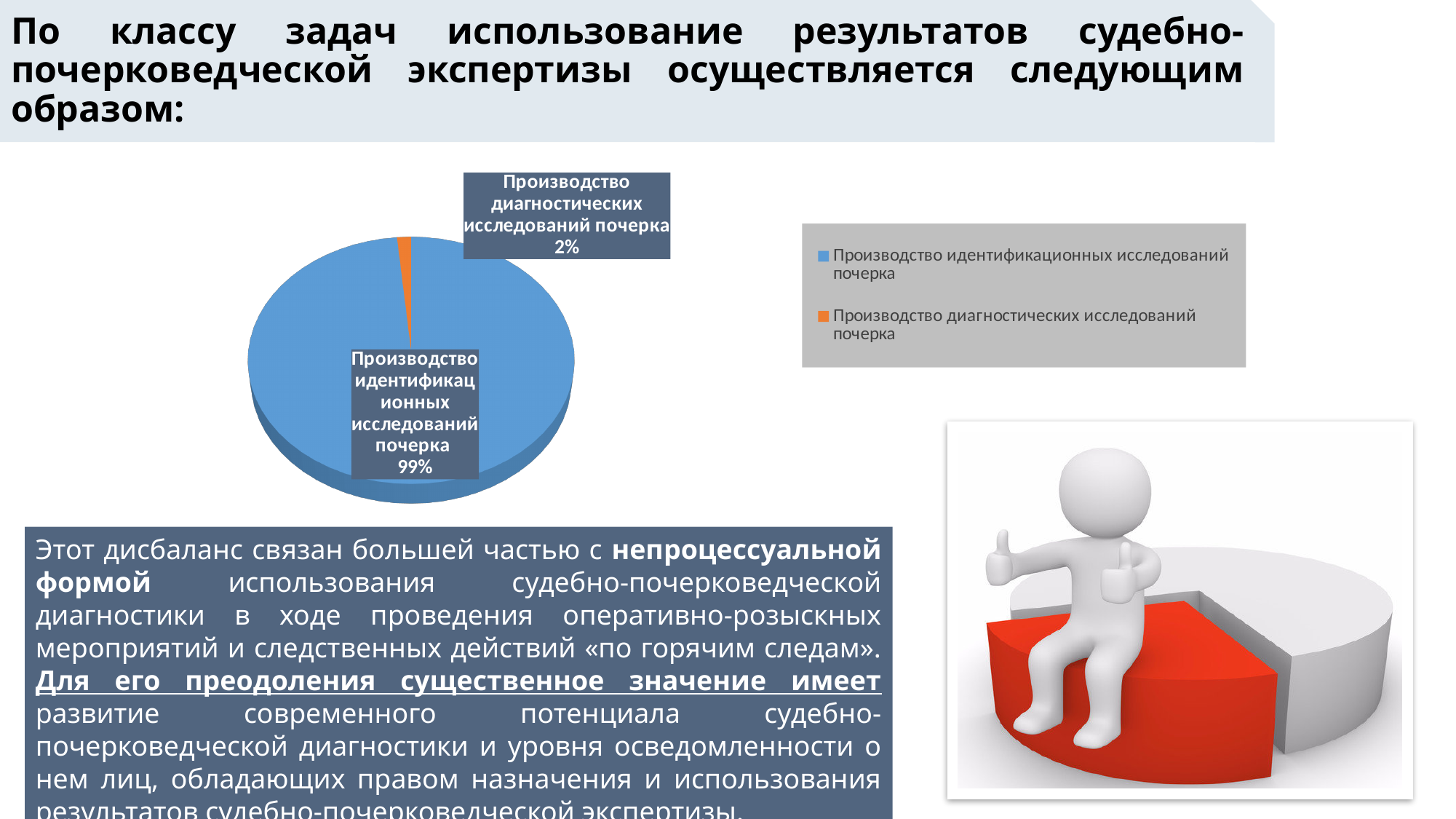
Which category has the largest slice of the pie? Производство идентификационных исследований почерка What is the difference in percentage points between the labelled shares of the two slices? 97 Which is larger: the slice for identification studies (идентификационных исследований) or the slice for diagnostic studies (диагностических исследований)? Производство идентификационных исследований почерка Which category has the smallest slice of the pie? Производство диагностических исследований почерка What share of the pie is labelled for "Производство диагностических исследований почерка"? 2% How many slices does the pie chart have? 2 What share of the pie is labelled for "Производство идентификационных исследований почерка"? 99% What kind of chart is shown on the slide? Pie chart What colour is the slice for "Производство идентификационных исследований почерка"? Blue How many entries does the legend list? 2 What colour is the slice for "Производство диагностических исследований почерка"? Orange